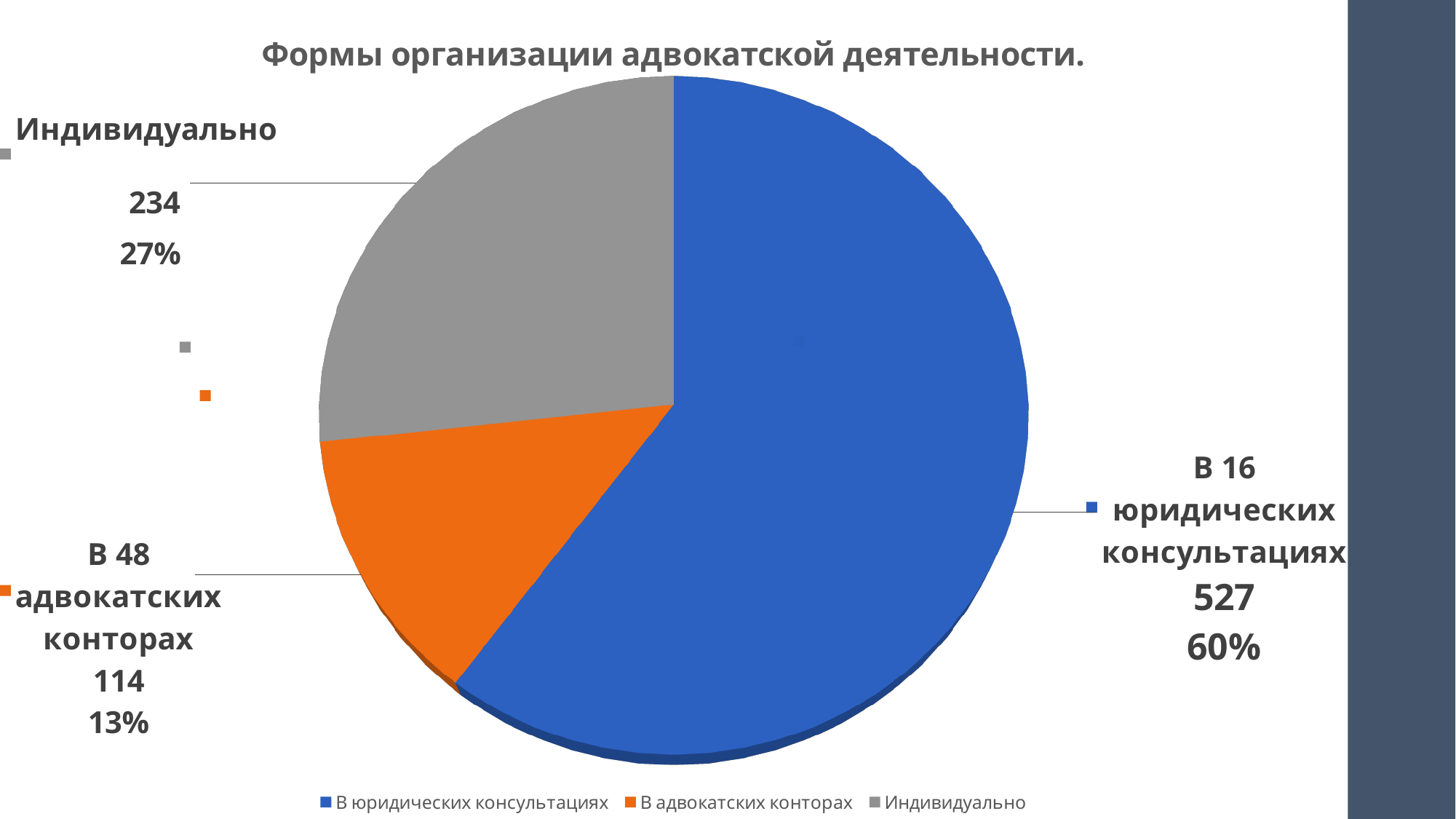
Which category has the smallest slice? В адвокатских конторах What is the difference between the values for Индивидуально and В адвокатских конторах? 120 How many slices does the pie chart have? 3 How many entries does the legend list? 3 Which category has the largest slice? В юридических консультациях What is the value for В юридических консультациях? 527 What kind of chart is shown on the slide? pie chart What is the title of the chart? Формы организации адвокатской деятельности. What is the value for Индивидуально? 234 What share of the pie does В юридических консультациях represent? 60% What is the value for В адвокатских конторах? 114 What share of the pie does Индивидуально represent? 27%